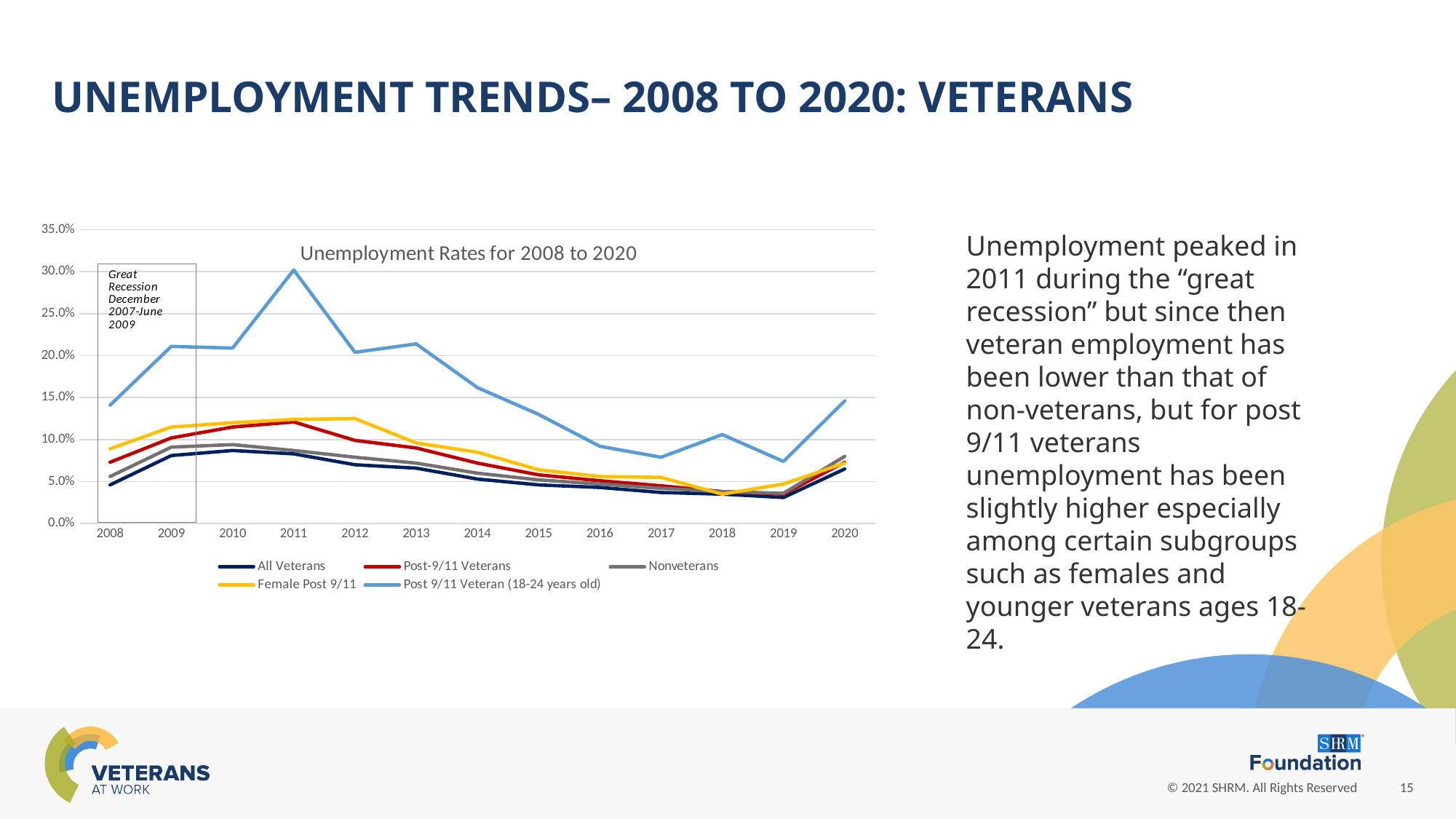
In which year does the Post 9/11 Veteran (18-24 years old) series reach its highest value? 2011 Does the Post 9/11 Veteran (18-24 years old) series rise or fall from 2011 to 2017? fall What kind of chart is shown on the slide? line chart Is the value for All Veterans in 2019 greater or less than 5.0%? less Which series has the highest value in 2011? Post 9/11 Veteran (18-24 years old) Is the value for Female Post 9/11 in 2012 greater or less than 10.0%? greater In 2020, which is larger: the value for Post 9/11 Veteran (18-24 years old) or the value for Nonveterans? Post 9/11 Veteran (18-24 years old) Is the value for Post 9/11 Veteran (18-24 years old) in 2011 greater or less than 25.0%? greater What is the title printed inside the chart area? Unemployment Rates for 2008 to 2020 How many series does the legend of the chart list? 5 How many years are plotted along the x axis of the chart? 13